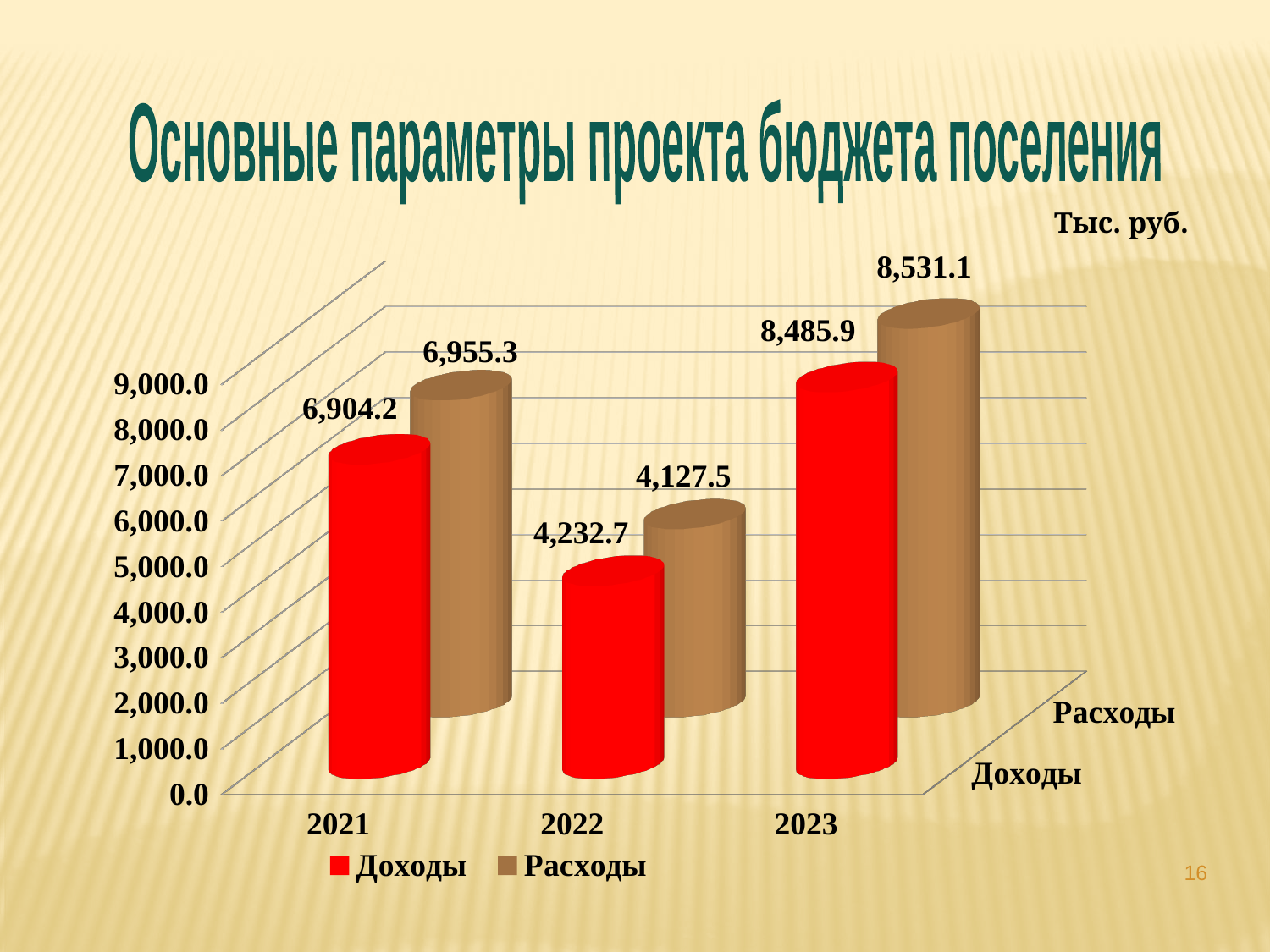
What is the value of Доходы for 2021? 6,904.2 In which year is Расходы the lowest? 2022 What is the value of Расходы for 2023? 8,531.1 What is the difference between Доходы in 2023 and Доходы in 2021? 1,581.7 What is the difference between Расходы and Доходы in 2021? 51.1 What kind of chart is shown on the slide? Bar chart How many years are shown on the x axis? 3 What is the value of Доходы for 2022? 4,232.7 How many series does the legend list? 2 In which year is Доходы the highest? 2023 What is the value of Расходы for 2022? 4,127.5 Which is larger in 2022, Доходы or Расходы? Доходы